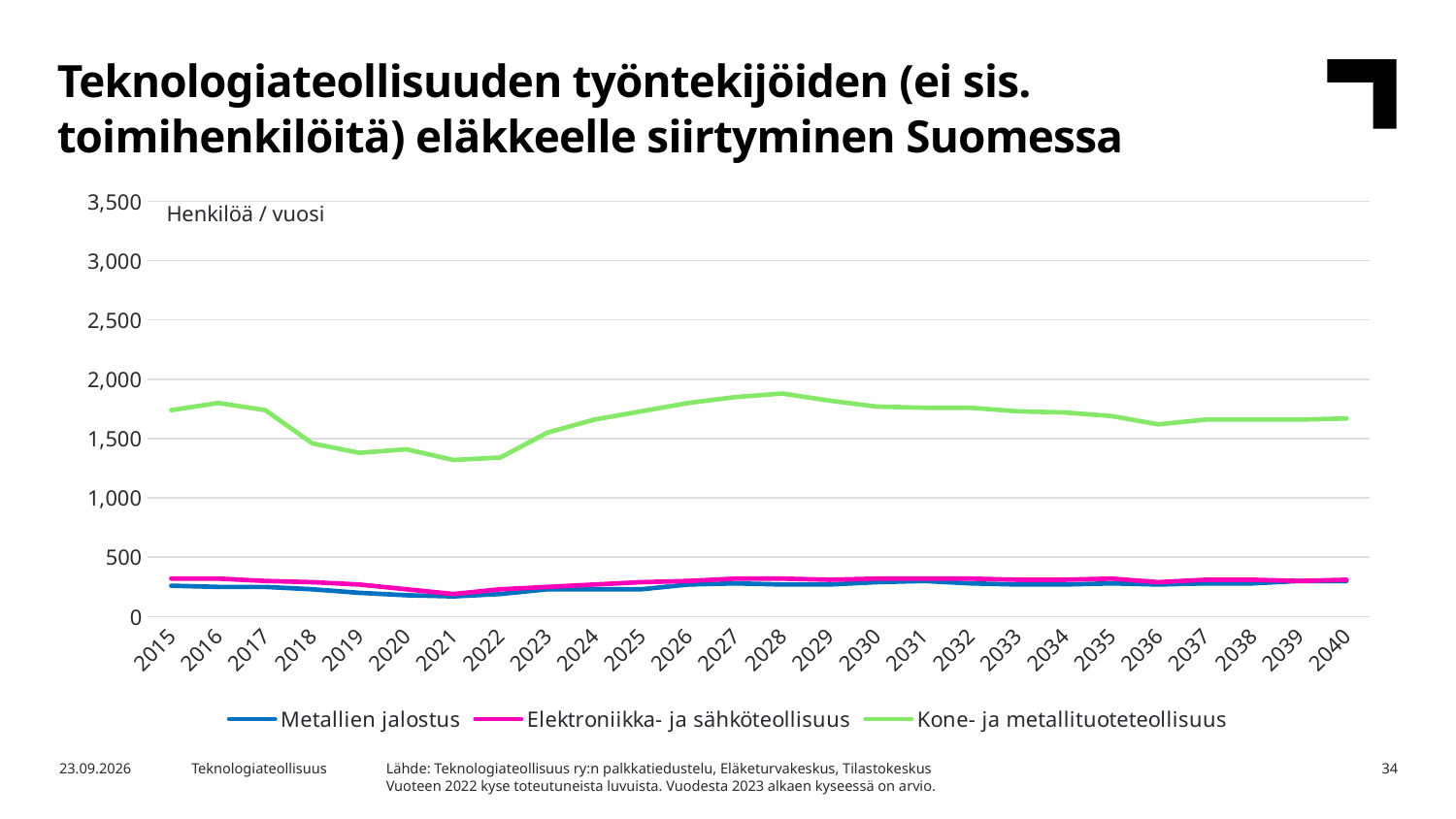
Is the value for Kone- ja metallituoteteollisuus in 2021 greater or less than 1,500? less How many series does the legend list? 3 Is the value for Kone- ja metallituoteteollisuus in 2028 greater or less than 2,000? less Which is larger in 2030, the value for Kone- ja metallituoteteollisuus or the value for Metallien jalostus? Kone- ja metallituoteteollisuus Does the Kone- ja metallituoteteollisuus line rise or fall from 2021 to 2028? rise What kind of chart is shown on the slide? line chart Is the value for Metallien jalostus in 2021 greater or less than 500? less Which series has the highest values across the whole period? Kone- ja metallituoteteollisuus How many years are shown on the x axis? 26 Does the Kone- ja metallituoteteollisuus line rise or fall from 2015 to 2021? fall What unit label is shown at the top of the chart's y axis? Henkilöä / vuosi